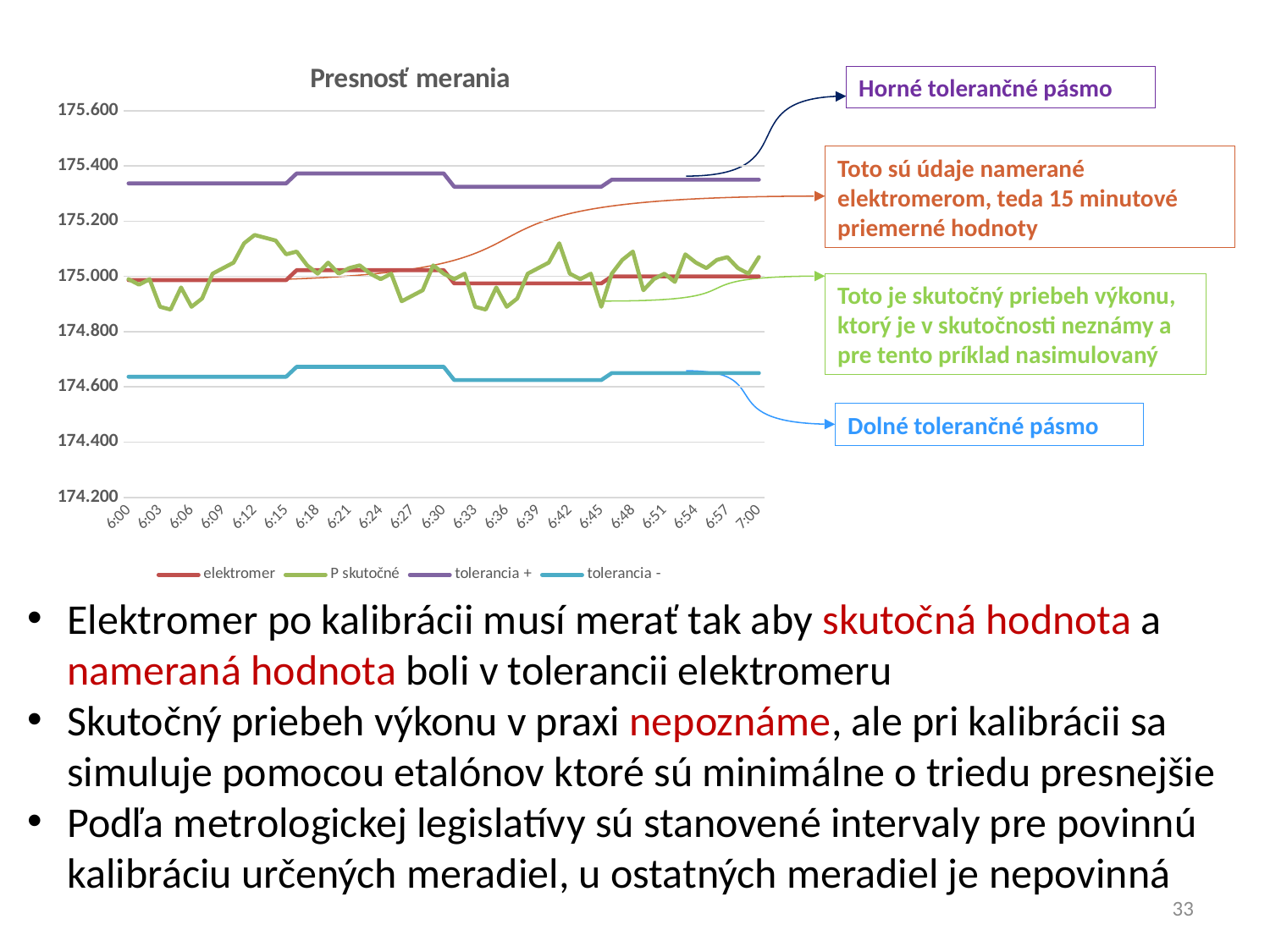
Which series are listed in the chart legend? elektromer, P skutočné, tolerancia +, tolerancia - How many series does the chart legend list? 4 Which series has the lowest values across the whole chart? tolerancia - Does the tolerancia - line rise or fall between 6:30 and 6:33? fall At 6:00, which is larger: tolerancia + or elektromer? tolerancia + What kind of chart is shown on the slide? line chart How many time labels are shown on the x axis of the chart? 21 What is the title of the chart? Presnosť merania Is the value of P skutočné at 6:12 greater or less than 175.000? greater Is the value of tolerancia - at 6:00 greater or less than 174.800? less Which series has the highest values across the whole chart? tolerancia + Is the value of tolerancia + at 6:00 greater or less than 175.200? greater